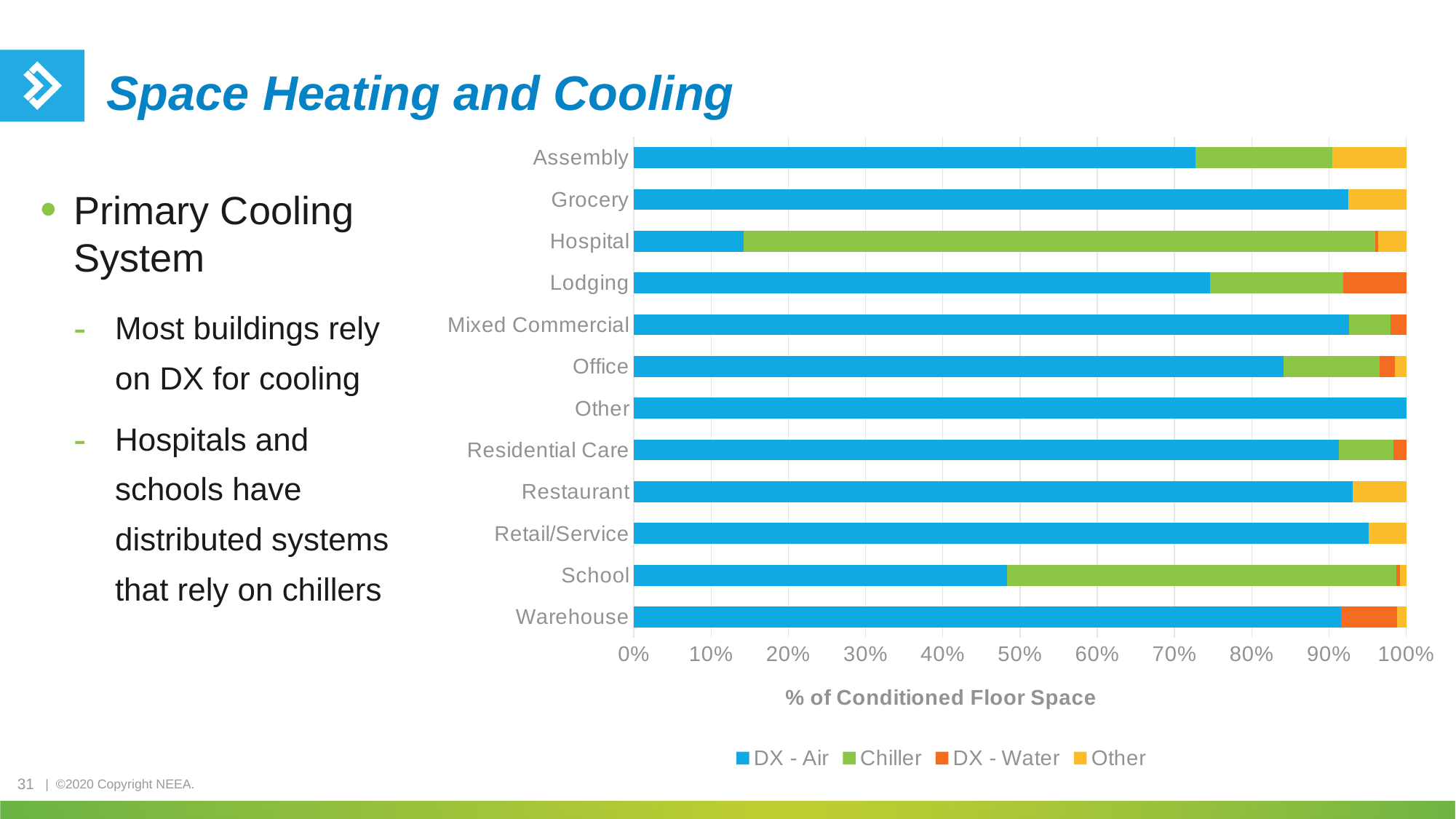
Which building type has the largest DX - Air share of conditioned floor space? Other How many building types are listed on the chart's vertical axis? 12 What is the title of the chart's horizontal axis? % of Conditioned Floor Space Which building type has the smallest DX - Air share of conditioned floor space? Hospital Is the DX - Air share for Assembly greater or less than 70%? greater Which has a larger DX - Air share, Hospital or School? School What kind of chart is shown on the slide? Stacked bar chart Which has a larger DX - Water share, Lodging or Office? Lodging How many series does the chart legend list? 4 Is the DX - Air share for Hospital greater or less than 20%? less Which series is shown in green in the chart legend? Chiller Which building type has the largest Chiller share of conditioned floor space? Hospital